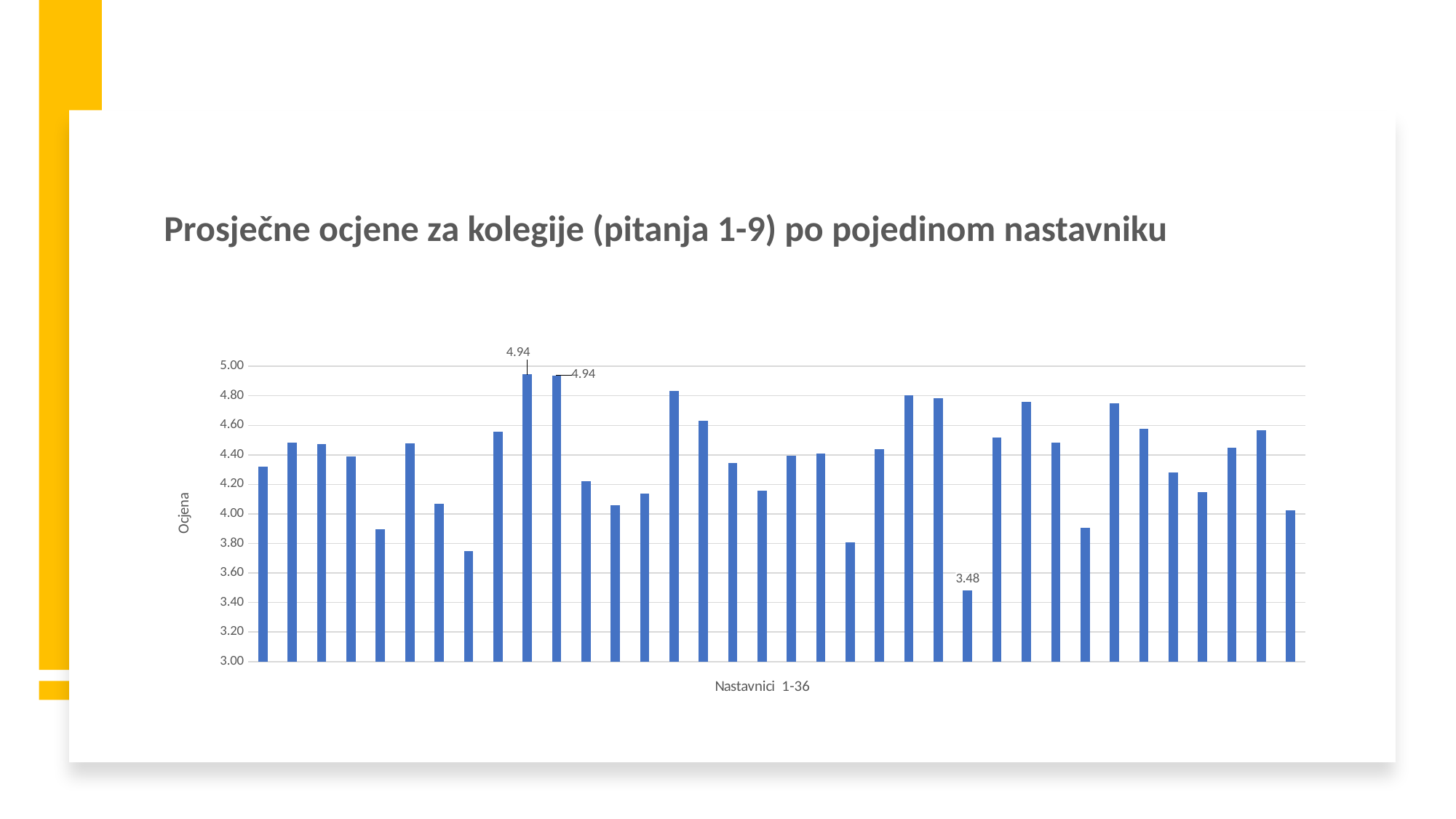
How many bars carry the data label 4.94? 2 How many bars (teachers) are plotted in the chart? 36 What kind of chart is shown on the slide? Bar chart Is the value for the first bar from the left greater or less than 4.20? greater Which is larger, the value of the 10th bar from the left (labelled 4.94) or the value of the 25th bar from the left (labelled 3.48)? The 10th bar (4.94) What is the difference between the highest labelled value (4.94) and the lowest labelled value (3.48)? 1.46 What is the lowest value labelled on the chart? 3.48 Is the value for the fifth bar from the left greater or less than 4.00? less What is the highest value labelled on the chart? 4.94 Is the value for the last bar on the right greater or less than 4.20? less What is the title of the chart? Prosječne ocjene za kolegije (pitanja 1-9) po pojedinom nastavniku What is the label on the vertical axis? Ocjena